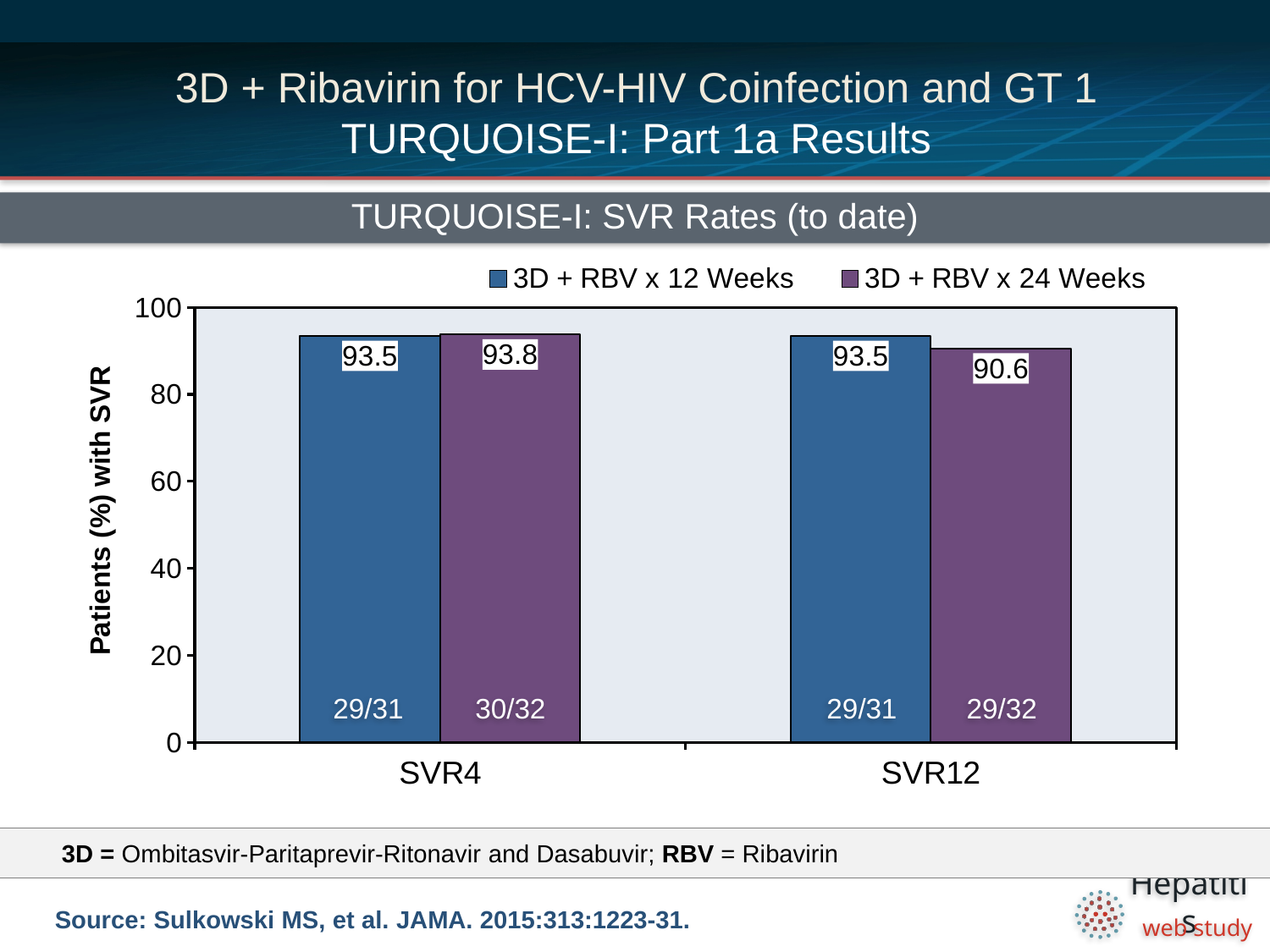
What kind of chart is shown on the slide? Bar chart What fraction is shown in the SVR4 bar for 3D + RBV x 12 Weeks? 29/31 What is the title of the chart? TURQUOISE-I: SVR Rates (to date) Is the SVR12 value for 3D + RBV x 24 Weeks greater or less than 80? greater How many series does the legend list? 2 What is the SVR12 rate for 3D + RBV x 12 Weeks? 93.5 What is the SVR4 rate for 3D + RBV x 24 Weeks? 93.8 How many patients achieved SVR12 in the 3D + RBV x 24 Weeks arm, as shown by the fraction in the bar? 29/32 What is the difference between the SVR12 rates for 3D + RBV x 12 Weeks and 3D + RBV x 24 Weeks? 2.9 What is the SVR4 rate for 3D + RBV x 12 Weeks? 93.5 Which bar has the lowest value on the chart? 3D + RBV x 24 Weeks at SVR12 What is the SVR12 rate for 3D + RBV x 24 Weeks? 90.6